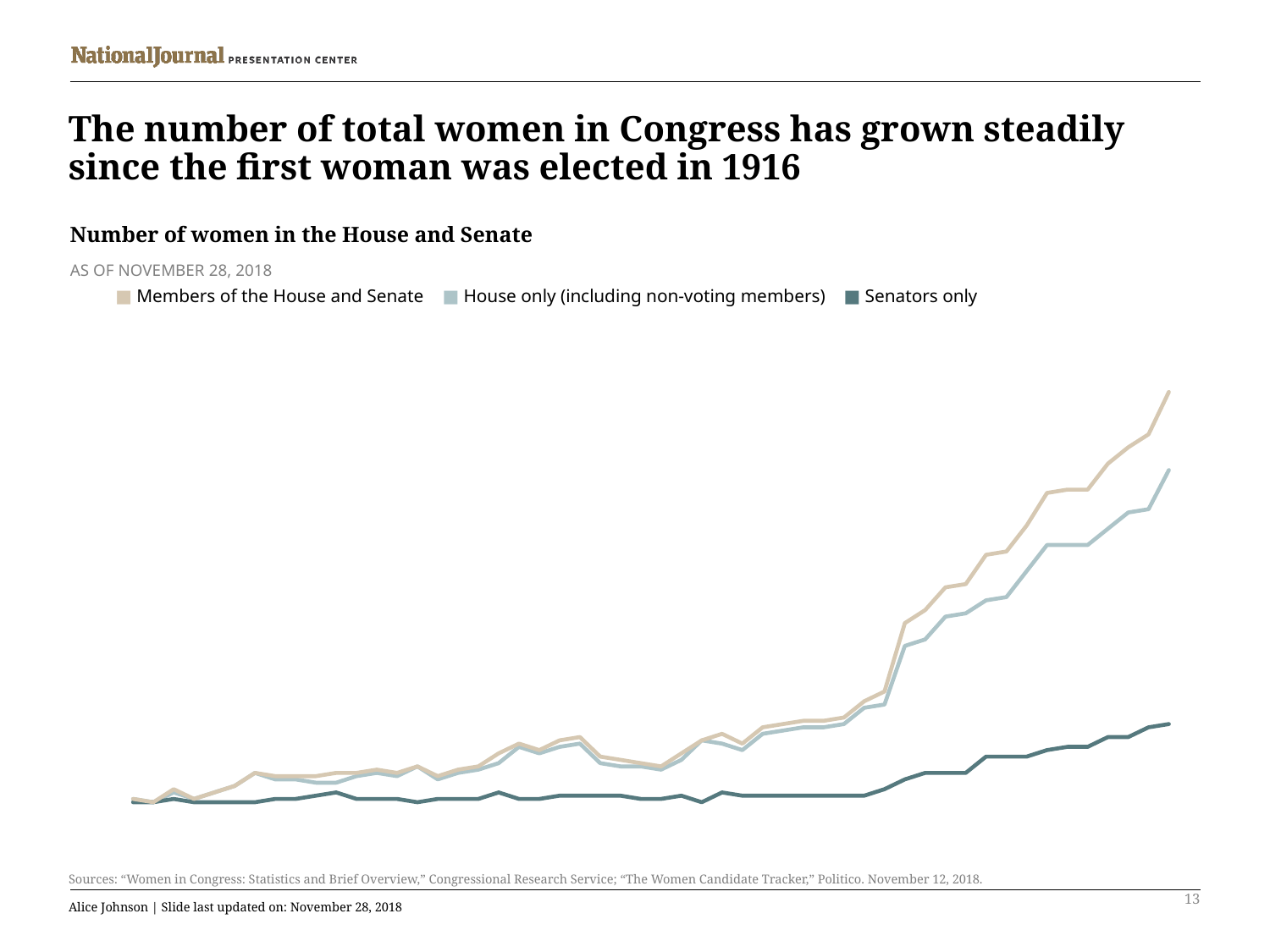
What kind of chart is shown on the slide? Line chart What is the title of the chart? Number of women in the House and Senate Do the values for Senators only rise or fall overall along the x axis? Rise Which series has the lowest value at the right end of the chart? Senators only Which series has the highest value at the right end of the chart? Members of the House and Senate What are the three series listed in the legend? Members of the House and Senate; House only (including non-voting members); Senators only At the right end of the chart, is the value for House only (including non-voting members) larger or smaller than the value for Senators only? Larger How many series does the legend list? 3 Do the values for Members of the House and Senate rise or fall overall along the x axis? Rise Do the values for House only (including non-voting members) rise or fall overall along the x axis? Rise